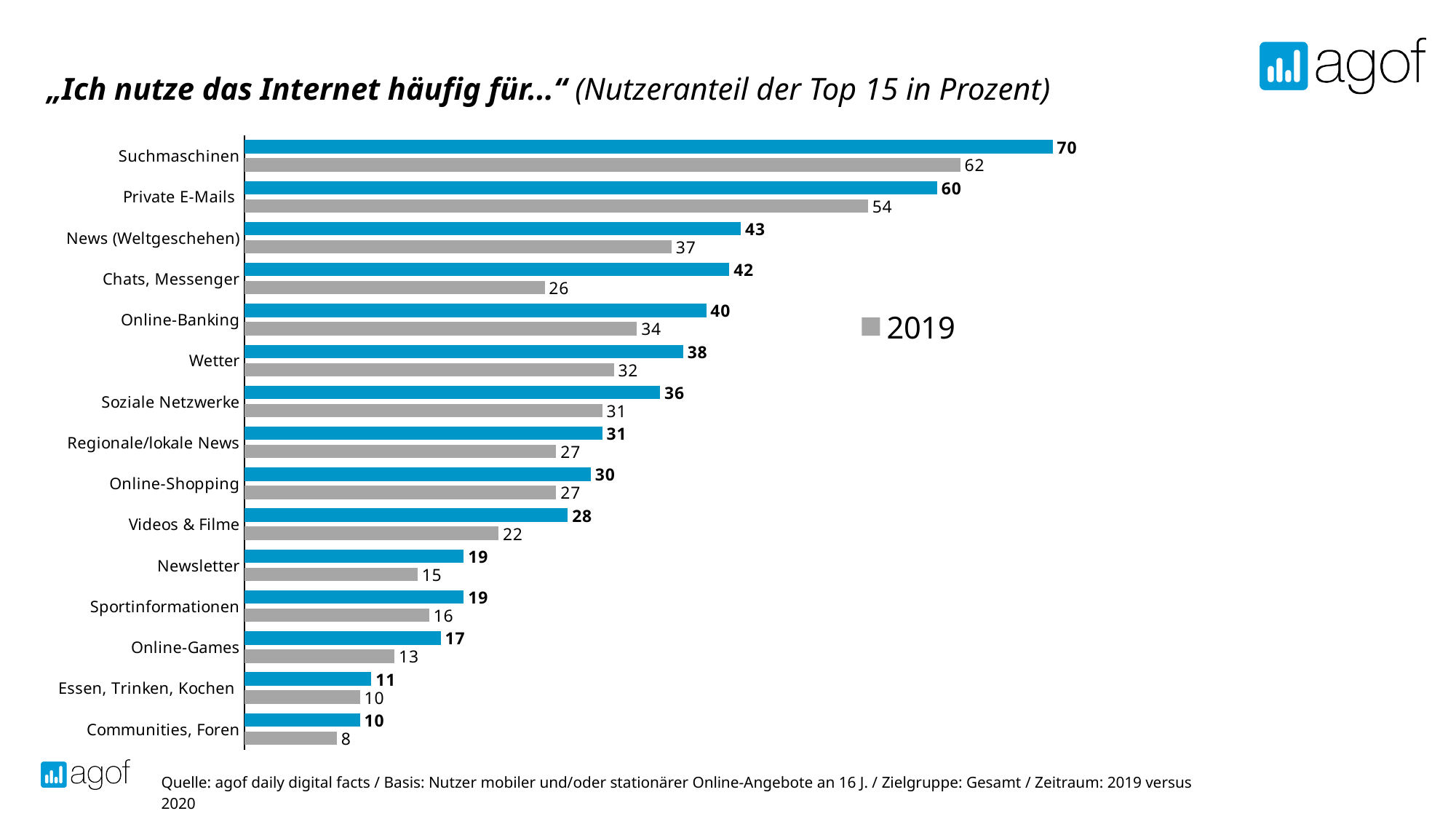
What is the difference between the 2019 values for Private E-Mails and News (Weltgeschehen)? 17 What kind of chart is shown on the slide? Bar chart Which series is listed in the chart legend? 2019 How many categories are shown on the chart? 15 What is the 2019 value for Online-Banking? 34 Which category has the lowest 2019 value? Communities, Foren Which has a higher 2019 value, Wetter or Soziale Netzwerke? Wetter Which category has the highest 2019 value? Suchmaschinen What colour are the 2019 bars? Grey What is the value of the blue bar for Chats, Messenger? 42 What is the difference between the blue bar and the 2019 bar for Chats, Messenger? 16 What is the 2019 value for Suchmaschinen? 62